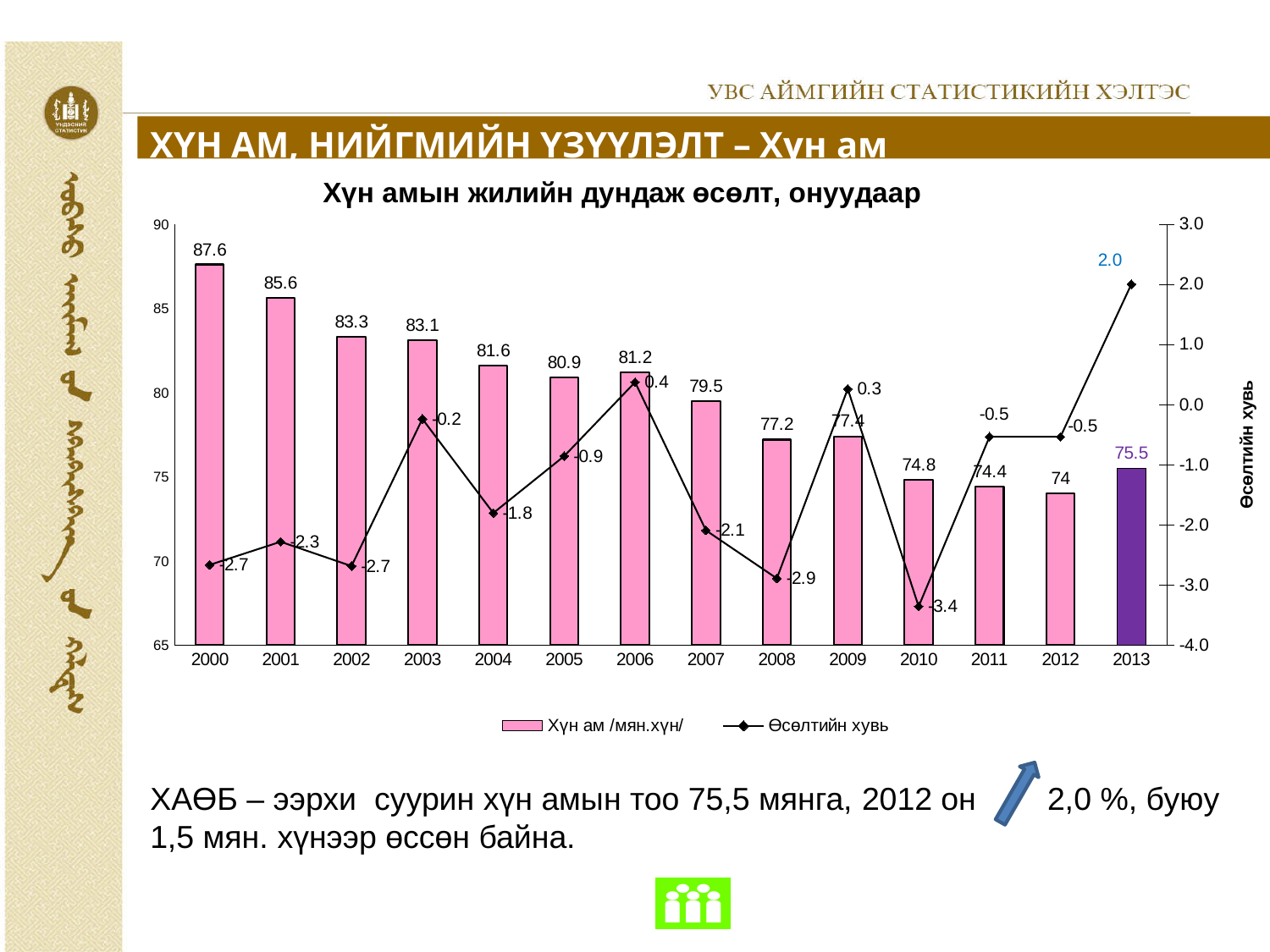
Do the population bars generally rise or fall from 2000 to 2012? Fall Which year has the lowest population bar? 2012 How many years are shown on the x axis? 14 What is the difference between the population values for 2013 and 2012? 1.5 What kind of chart is shown on the slide? Combined bar and line chart Which year has the lowest growth rate on the line? 2010 How many series does the legend list? 2 What is the growth rate (Өсөлтийн хувь) shown for 2010? -3.4 What is the population value (Хүн ам /мян.хүн/) shown for 2013? 75.5 Which year has the highest population bar? 2000 What is the growth rate (Өсөлтийн хувь) shown for 2013? 2.0 Which is larger, the population value for 2008 or for 2009? 2009